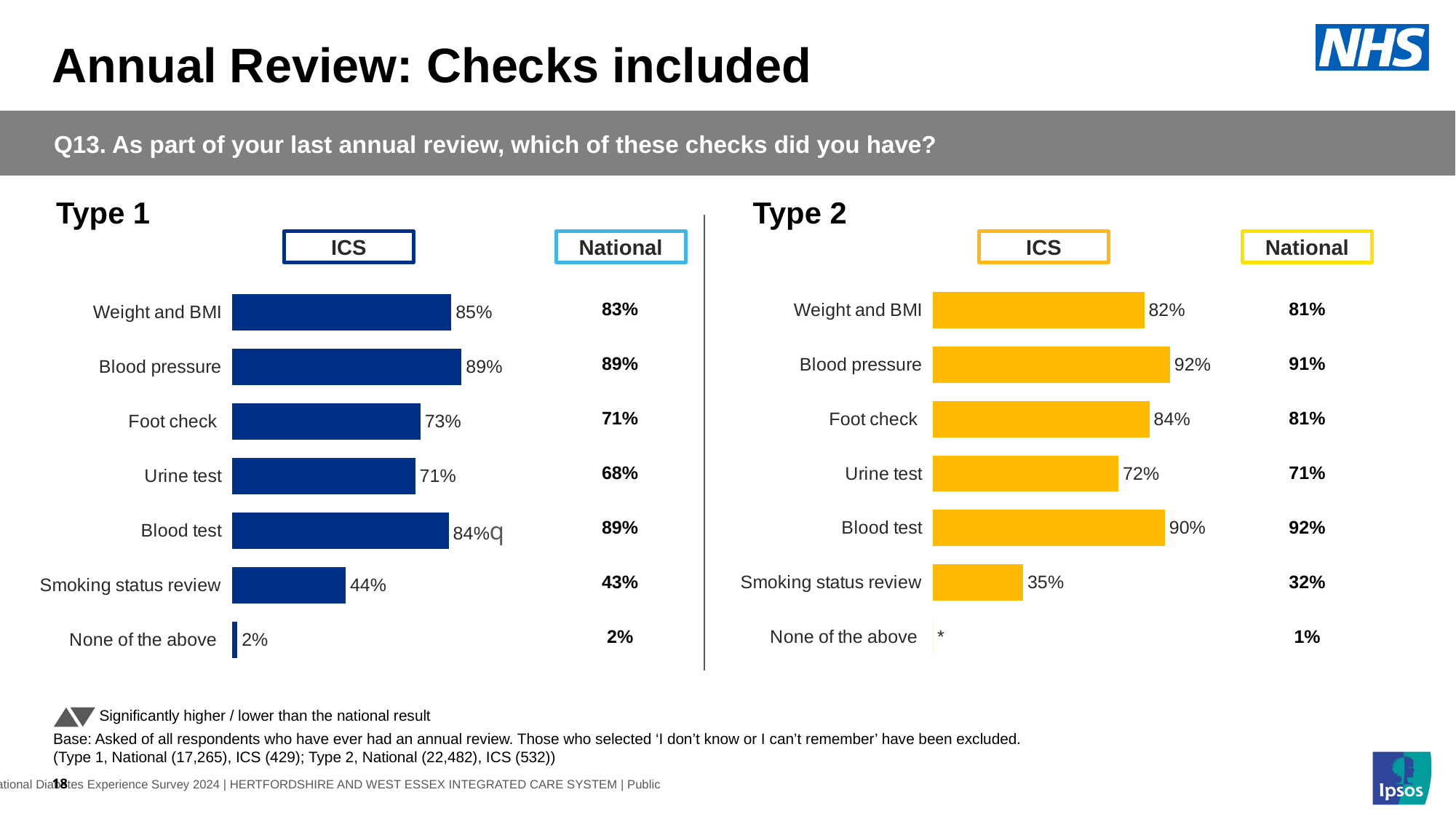
In the Type 2 chart, is the ICS value for Foot check larger or smaller than the National value for Foot check? larger In the Type 1 chart, which check has the highest ICS value? Blood pressure In the Type 2 chart, what is the difference between the ICS values for Blood pressure and Urine test? 20% What colour are the bars in the Type 2 chart? yellow How many checks are listed in the Type 1 chart? 7 In the Type 1 chart, what is the ICS value for Foot check? 73% In the Type 2 chart, what is the ICS value for Blood pressure? 92% In the Type 2 chart, which check has the lowest ICS value among those with a printed percentage? Smoking status review In the Type 1 chart, what is the difference between the ICS and National values for Blood test? 5% In the Type 2 chart, what is the National value for Smoking status review? 32% What kind of chart is used for the Type 1 ICS results? bar chart In the Type 1 chart, what is the National value for Urine test? 68%